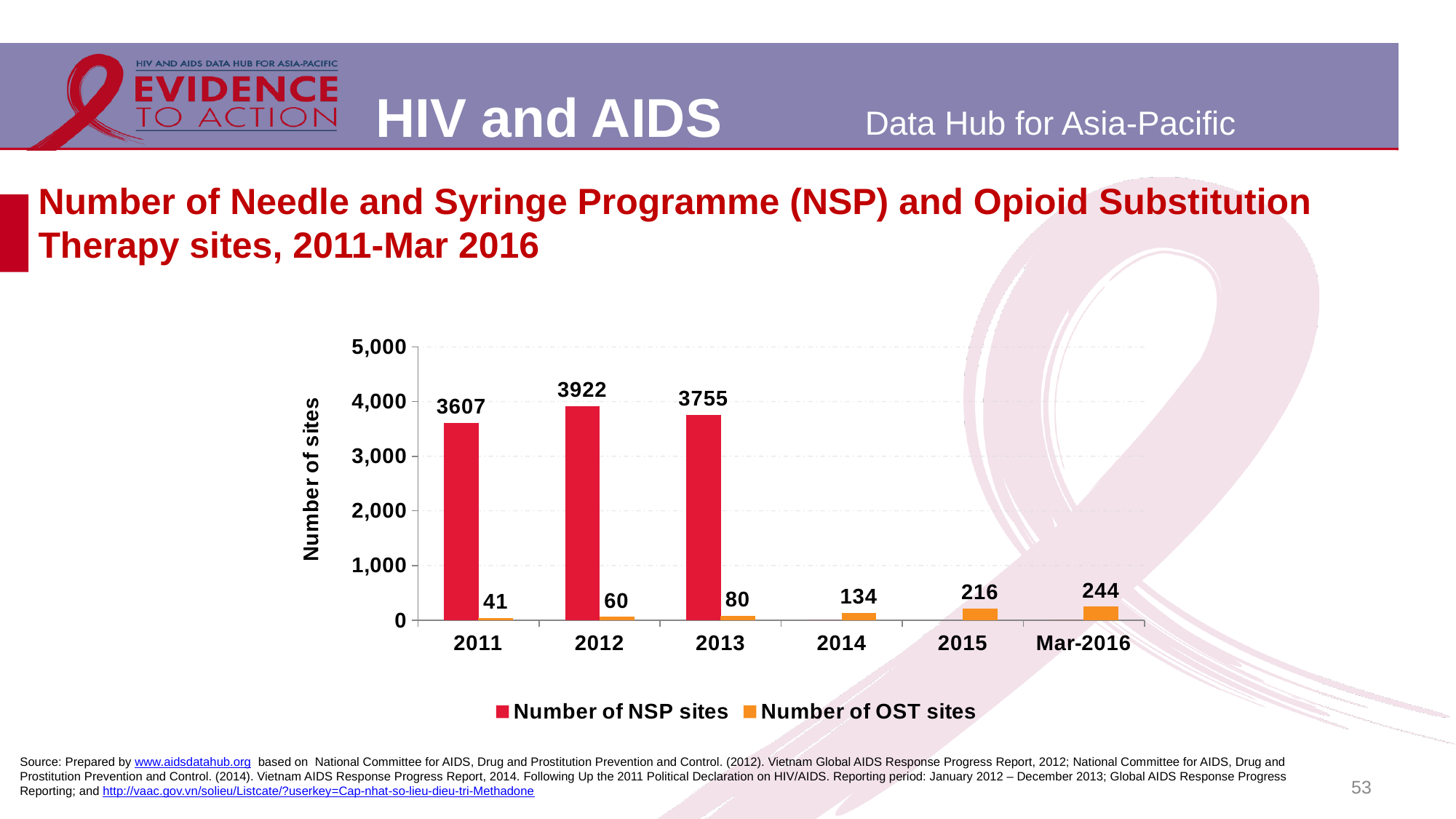
How many series does the legend list? 2 What is the number of OST sites in 2014? 134 What is the difference between the number of OST sites in 2015 and 2014? 82 What is the number of OST sites in Mar-2016? 244 In which year is the number of OST sites lowest? 2011 How many time periods are shown on the x axis? 6 What is the number of NSP sites in 2012? 3922 Does the number of OST sites rise or fall from 2011 to Mar-2016? rise Is the number of NSP sites in 2011 greater or less than 4,000? less In which year is the number of NSP sites highest? 2012 Which is larger, the number of NSP sites in 2011 or in 2013? 2013 What is the difference between the number of NSP sites in 2012 and 2013? 167